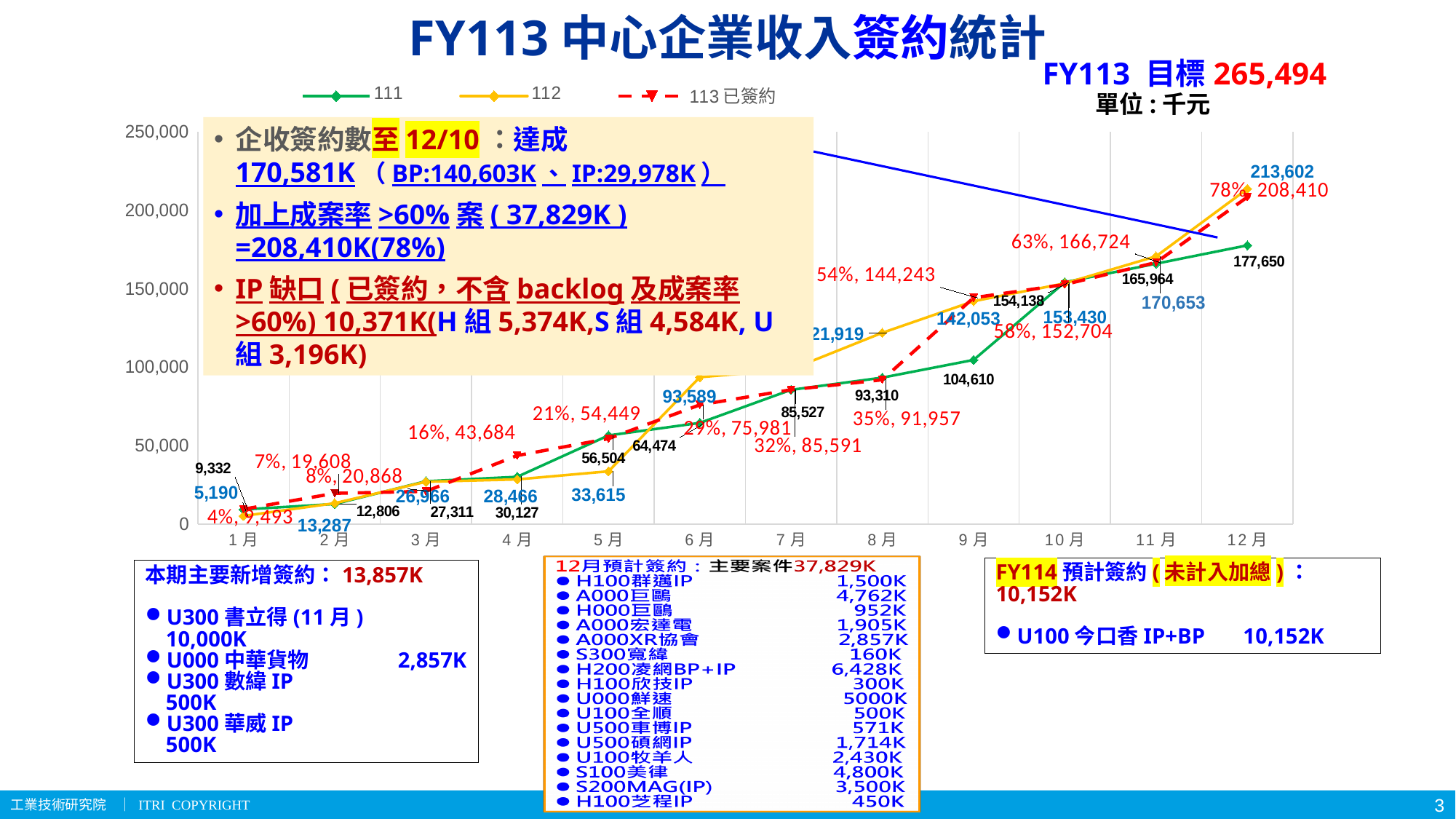
How many series does the chart legend list? 3 In which month does series 111 reach its highest value? 12月 What is the difference between series 112 and series 111 in 12月? 35,952 What is the value of series 113 已簽約 in 12月? 208,410 What is the value of series 111 in 12月? 177,650 How many months are shown along the x axis of the chart? 12 What is the FY113 target value stated on the slide? 265,494 In 12月, which series has the larger value, 111 or 112? 112 What is the value of series 112 in 12月? 213,602 What is the value of series 112 in 1月? 5,190 What kind of chart is shown on the slide? line chart What is the value of series 111 in 9月? 104,610